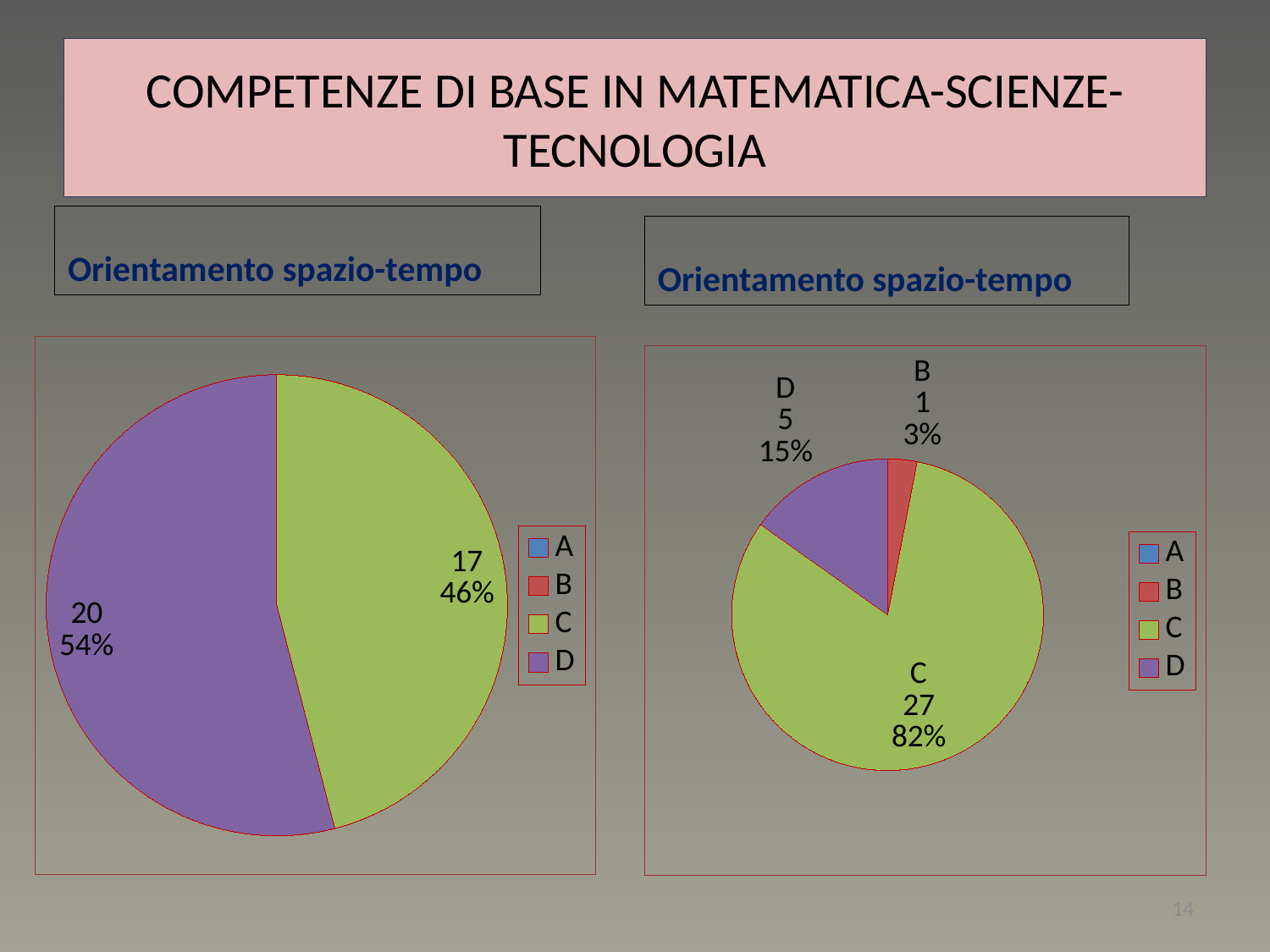
How many entries does the legend of the right pie chart list? 4 What is the title shown above the right pie chart? Orientamento spazio-tempo In the left pie chart, what is the value for category D? 20 In the right pie chart, which category has the smallest slice? B In the right pie chart, what is the value for category C? 27 In the right pie chart, which is larger, the value for D or the value for B? D In the left pie chart, what is the difference between the values for D and C? 3 In the right pie chart, what percentage share does category D have? 15% What type of chart is the left chart? Pie chart In the left pie chart, which category has the largest slice? D In the right pie chart, what is the difference between the values for C and D? 22 In the left pie chart, what percentage share does category C have? 46%